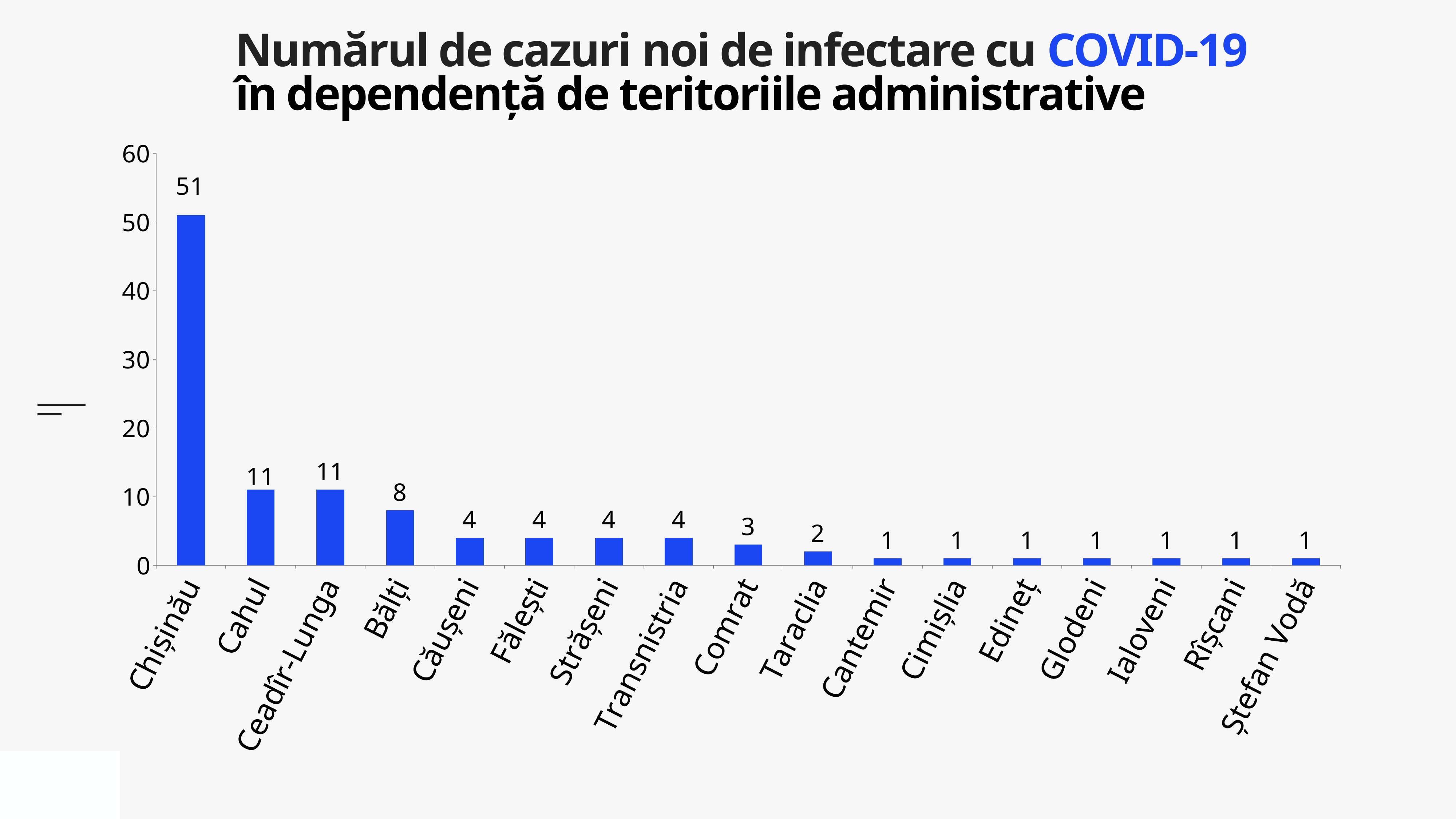
Which category has the highest value? Chișinău What is the difference between the values for Bălți and Căușeni? 4 What kind of chart is shown on the slide? bar chart Is the value for Chișinău greater or less than 40? greater What is the value for Chișinău? 51 What is the value for Taraclia? 2 Do the values rise or fall from left to right along the x axis? fall What is the value for Comrat? 3 How many categories are shown on the x axis? 17 What is the value for Bălți? 8 Which is larger, the value for Cahul or the value for Bălți? Cahul What is the difference between the values for Chișinău and Cahul? 40